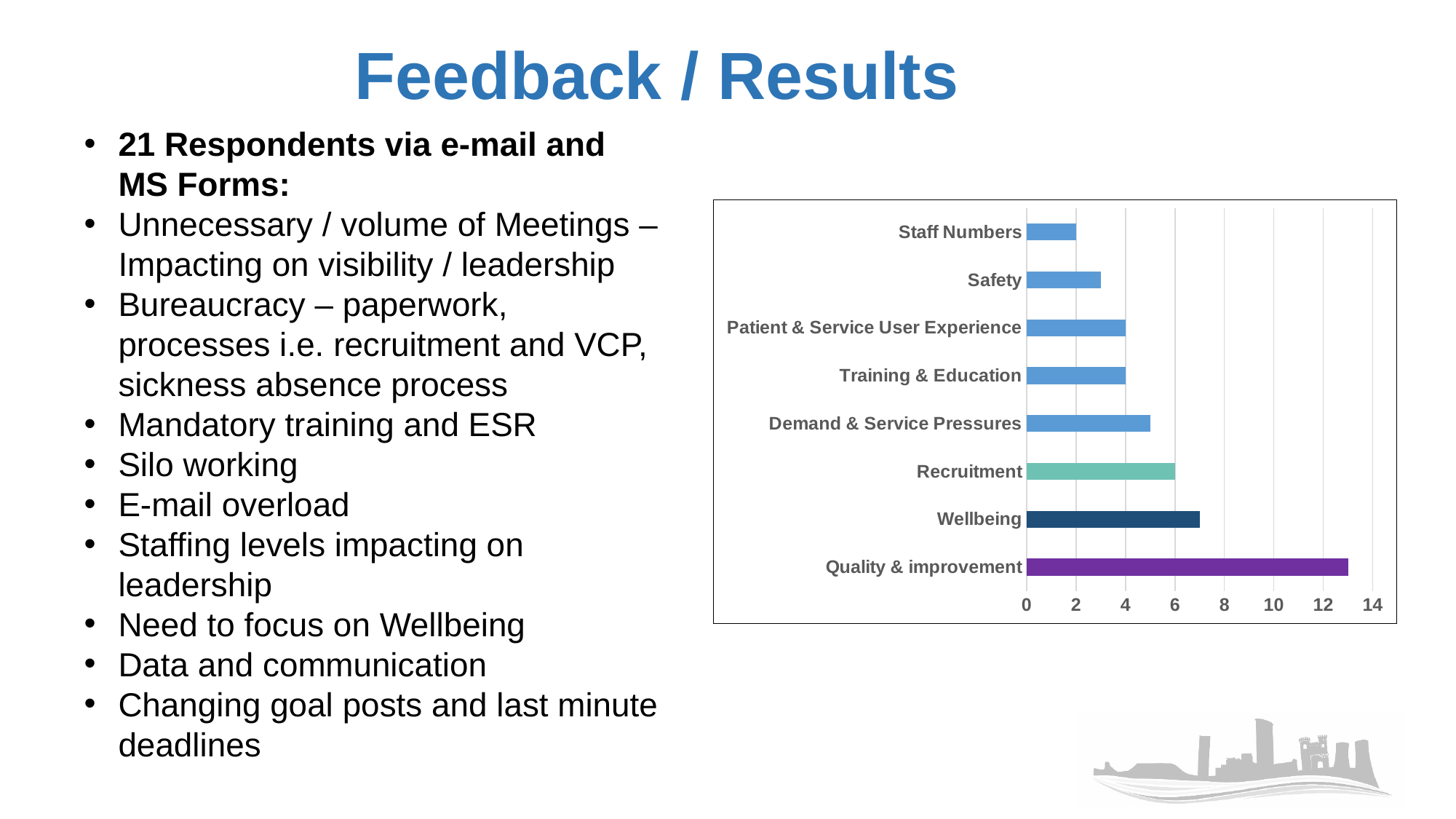
Which category has the lowest value in the chart? Staff Numbers What is the value for Training & Education? 4 Which category has the highest value in the chart? Quality & improvement What colour is the bar for Quality & improvement? purple What kind of chart is shown on the slide? bar chart Is the value for Wellbeing greater or less than 8? less Is the value for Safety greater or less than 4? less How many categories are plotted in the chart? 8 What is the value for Recruitment? 6 What is the value for Staff Numbers? 2 Which is larger, the value for Wellbeing or the value for Recruitment? Wellbeing Is the value for Quality & improvement greater or less than 12? greater